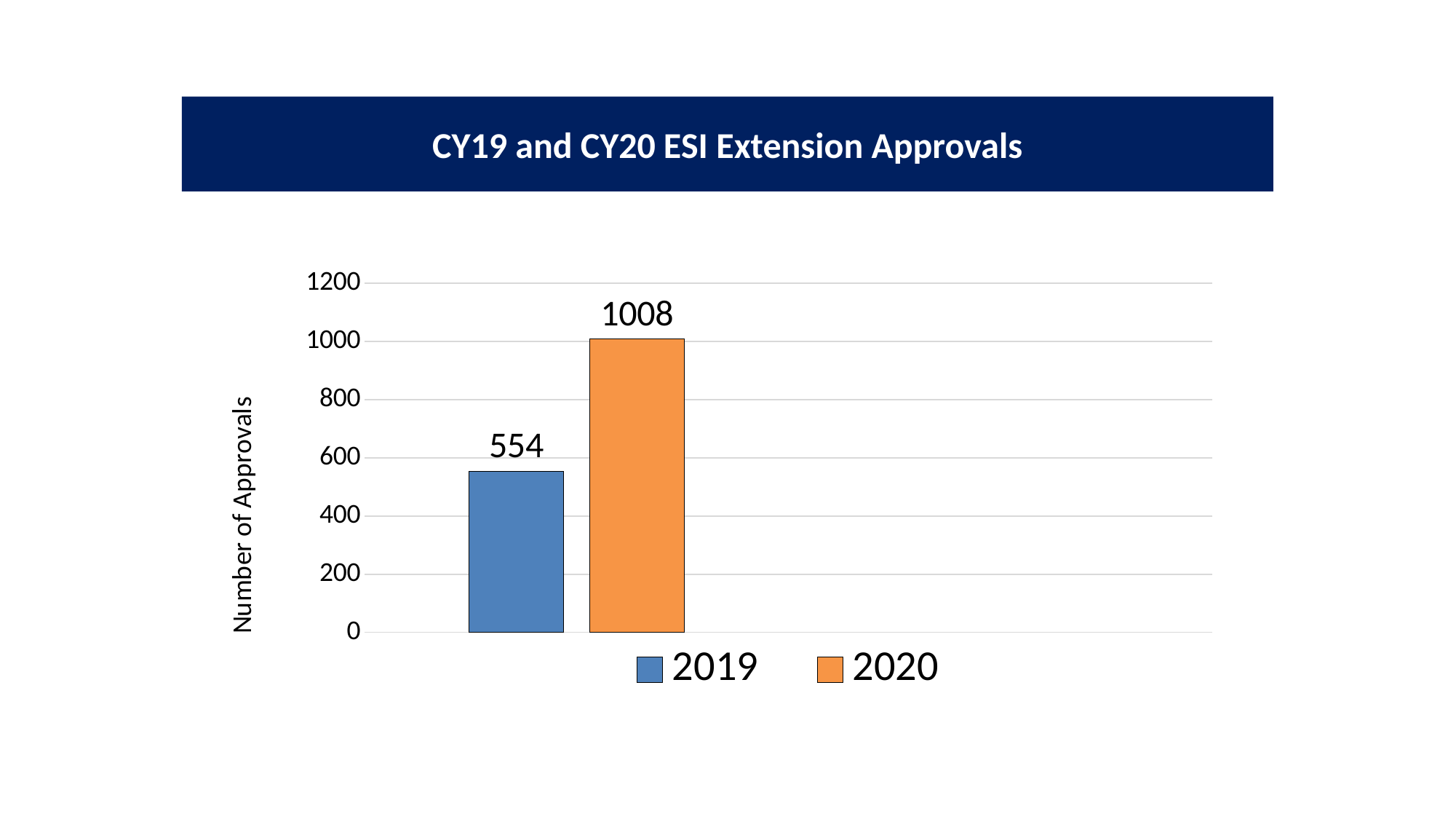
Is the value for 2020 greater or less than 1000? greater What is the number of ESI extension approvals for 2019? 554 What is the title of the chart? CY19 and CY20 ESI Extension Approvals How many series does the legend list? 2 What is the difference in approvals between 2020 and 2019? 454 How many bars are plotted on the chart? 2 What is the label on the vertical axis? Number of Approvals Which year has the higher number of approvals? 2020 Is the value for 2019 greater or less than 600? less What is the number of ESI extension approvals for 2020? 1008 Which year has the lower number of approvals? 2019 What kind of chart is shown on the slide? bar chart